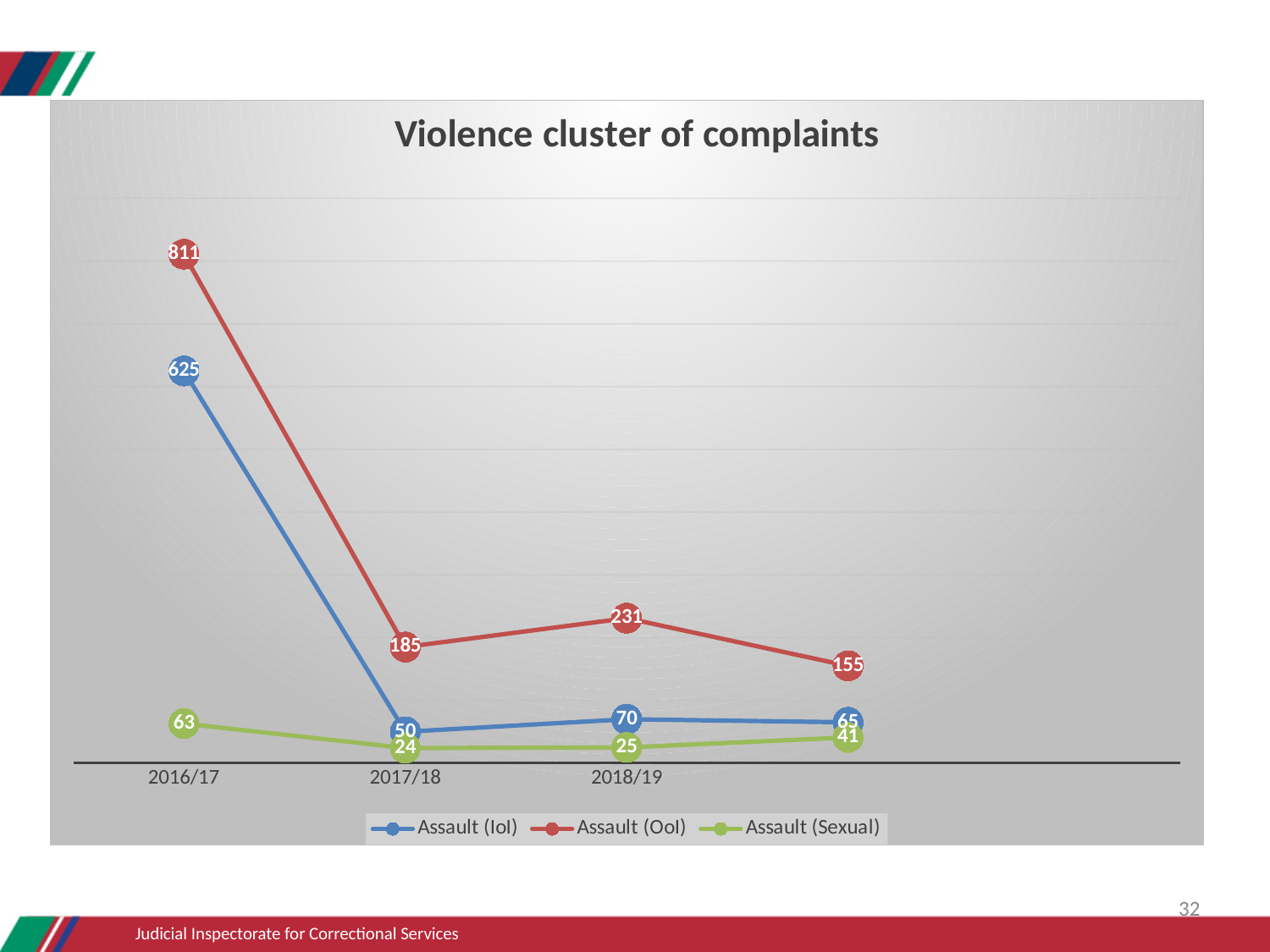
How many series does the legend list? 3 Does the Assault (IoI) series rise or fall from 2016/17 to 2017/18? fall What is the value for Assault (IoI) in 2017/18? 50 Which is larger in 2018/19, Assault (OoI) or Assault (IoI)? Assault (OoI) What type of chart is shown on the slide? line chart In which year is the Assault (Sexual) value lowest? 2017/18 What is the value for Assault (OoI) in 2016/17? 811 What is the value for Assault (Sexual) in 2018/19? 25 In which year is the Assault (OoI) value highest? 2016/17 What is the title of the chart? Violence cluster of complaints What is the difference between Assault (OoI) and Assault (IoI) in 2016/17? 186 What is the difference between Assault (OoI) in 2018/19 and in 2017/18? 46